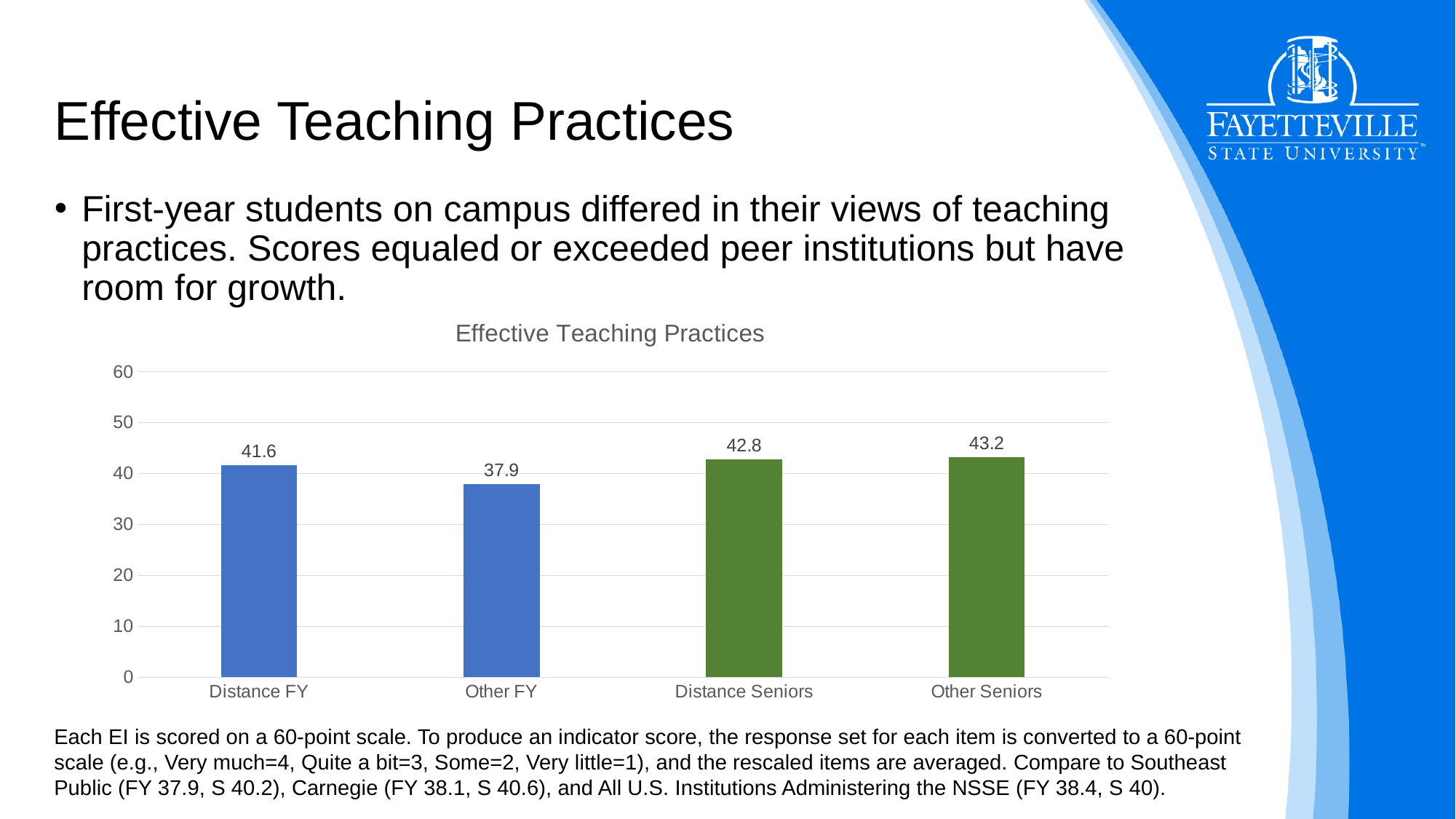
Which is larger, the value for Distance FY or the value for Other FY? Distance FY What kind of chart is shown on the slide? Bar chart Which category has the lowest value? Other FY How many categories are shown on the x axis? 4 What is the title of the chart? Effective Teaching Practices What is the value for Other FY? 37.9 What is the value for Other Seniors? 43.2 Is the value for Other FY greater or less than 40? less What is the value for Distance Seniors? 42.8 What is the difference between the values for Distance FY and Other FY? 3.7 What is the value for Distance FY? 41.6 What is the difference between the values for Other Seniors and Distance Seniors? 0.4